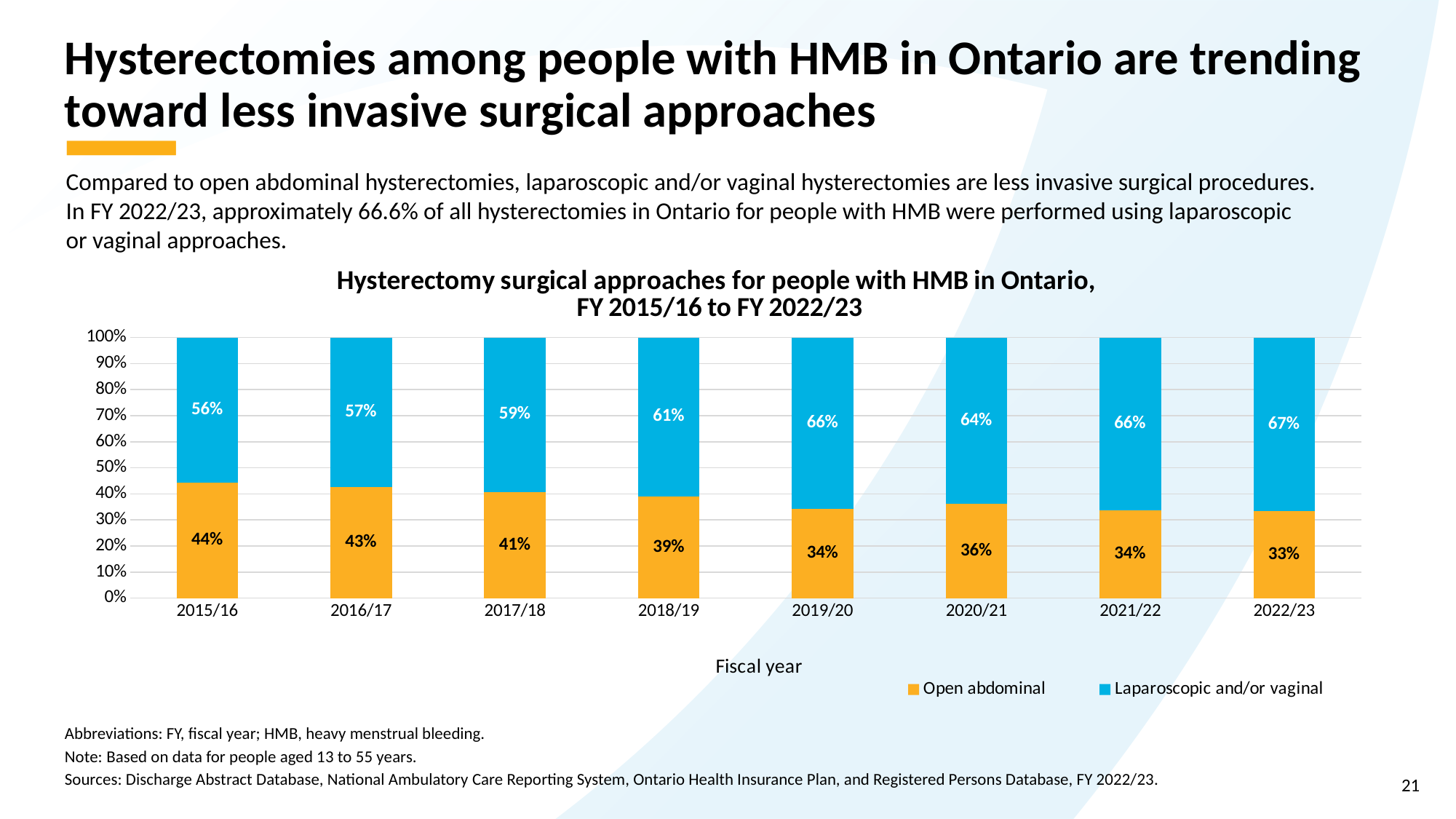
What is the value for Open abdominal in FY 2019/20? 34% How many fiscal years are shown on the x axis? 8 What kind of chart is shown on the slide? Stacked bar chart What percentage of hysterectomies were open abdominal in FY 2015/16? 44% Which colour represents Laparoscopic and/or vaginal in the chart? Blue Does the share of open abdominal hysterectomies generally rise or fall from FY 2015/16 to FY 2022/23? Fall How many series does the legend list? 2 Which fiscal year has the highest share of laparoscopic and/or vaginal hysterectomies? 2022/23 Which is larger: the laparoscopic and/or vaginal share in FY 2018/19 or in FY 2020/21? 2020/21 What is the difference between the open abdominal share in FY 2015/16 and FY 2022/23? 11 percentage points What percentage of hysterectomies were laparoscopic and/or vaginal in FY 2022/23? 67% Which fiscal year has the lowest share of open abdominal hysterectomies? 2022/23